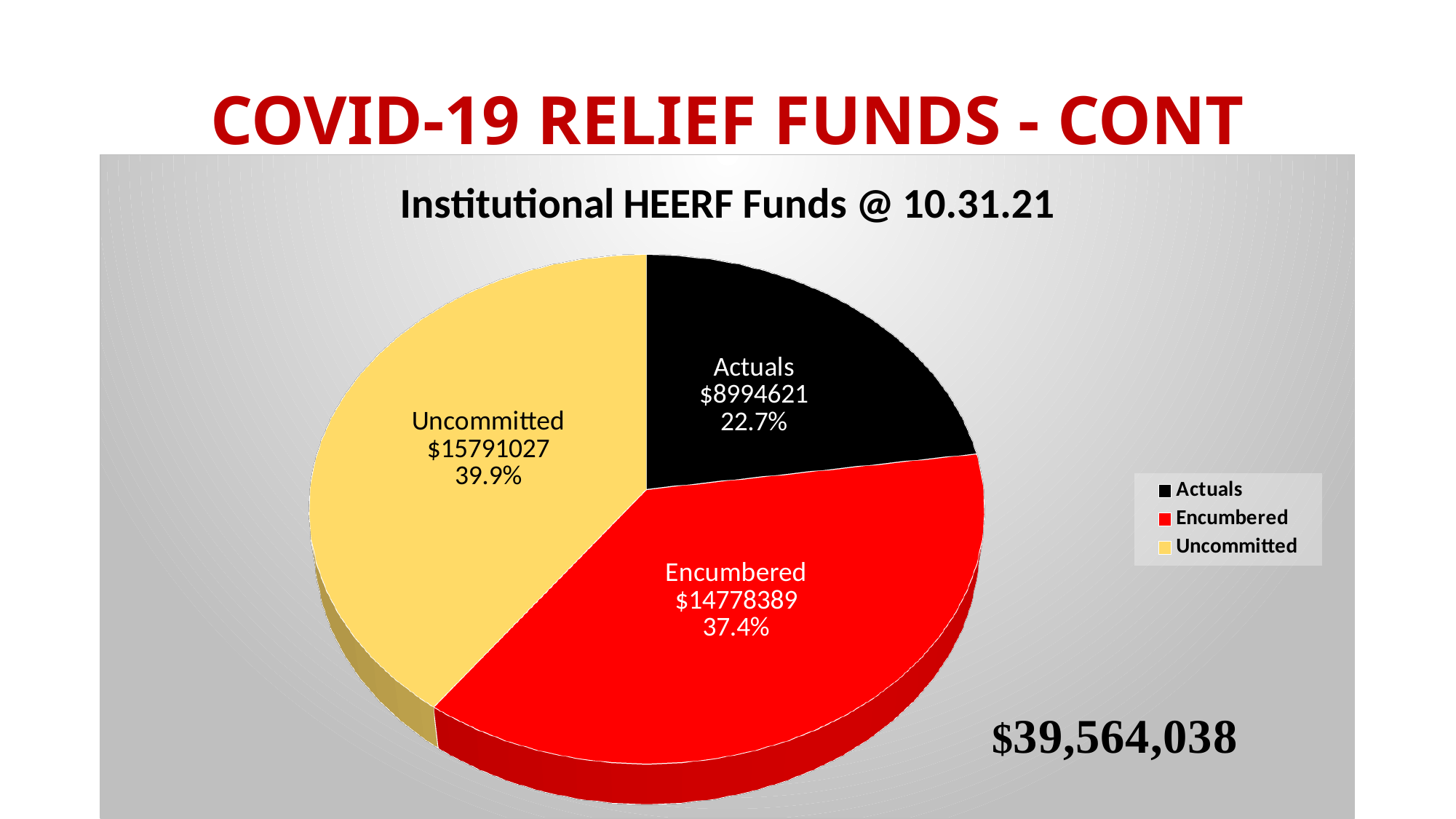
What is the dollar value of the Encumbered slice? $14778389 What type of chart is shown on the slide? Pie chart What share of the pie does the Encumbered slice represent? 37.4% Which category has the smallest slice of the pie? Actuals How many categories are shown in the pie chart? 3 What share of the pie does the Actuals slice represent? 22.7% What is the difference in dollars between the Uncommitted and Encumbered slices? $1012638 Which category has the largest slice of the pie? Uncommitted What is the title of the chart? Institutional HEERF Funds @ 10.31.21 What is the dollar value of the Uncommitted slice? $15791027 What is the dollar value of the Actuals slice? $8994621 What colour is the Encumbered slice? Red